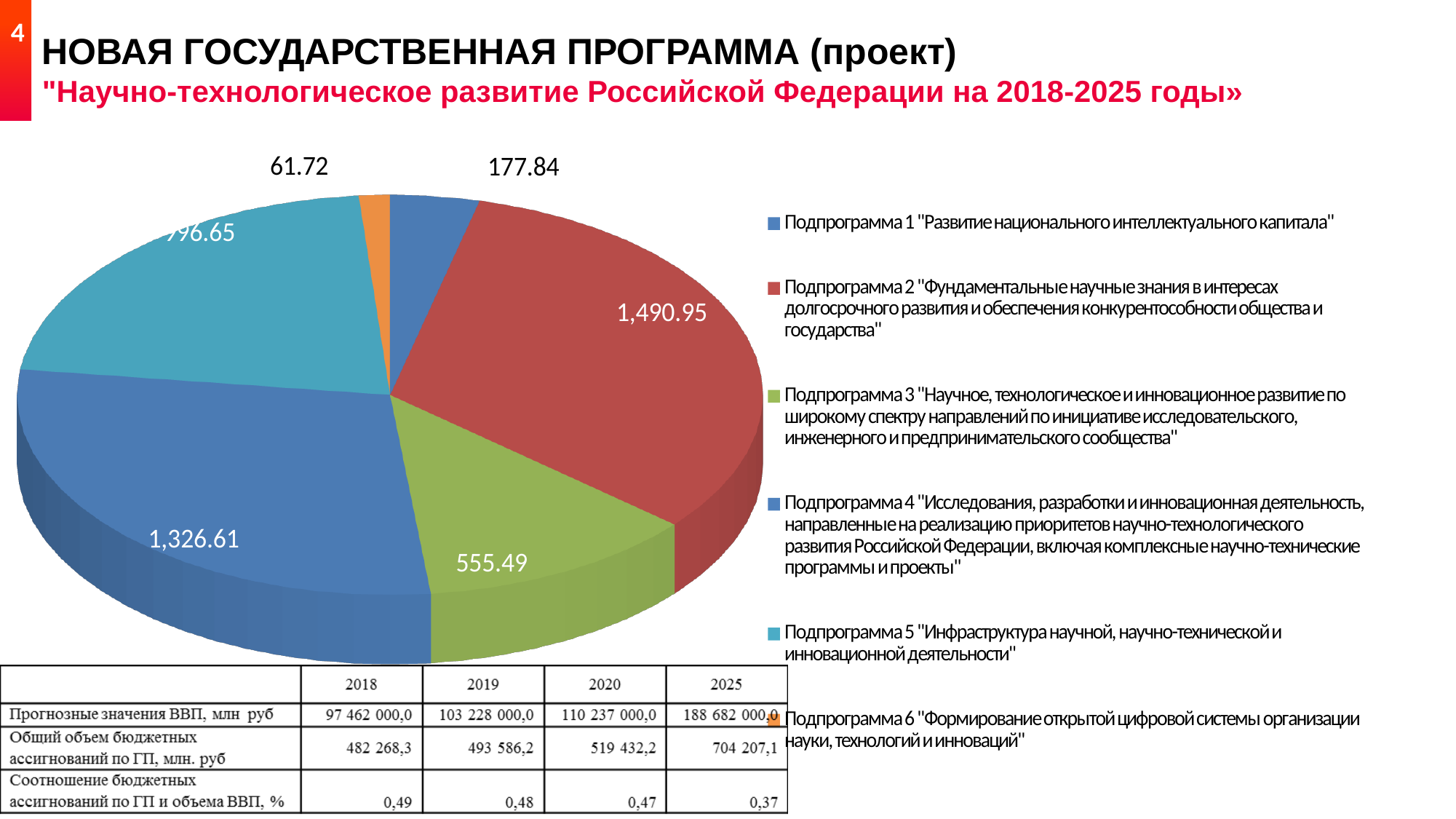
What colour is the slice for Подпрограмма 6 in the pie chart? orange How many entries does the legend of the pie chart list? 6 What type of chart is shown on the slide? pie chart Which is larger in the pie chart, the value for Подпрограмма 3 or the value for Подпрограмма 1? Подпрограмма 3 Which subprogram has the largest slice in the pie chart? Подпрограмма 2 How many slices does the pie chart have? 6 What is the value shown for Подпрограмма 2 in the pie chart? 1,490.95 What is the value shown for Подпрограмма 4 in the pie chart? 1,326.61 What is the value shown for Подпрограмма 3 in the pie chart? 555.49 What is the difference between the values for Подпрограмма 2 and Подпрограмма 4? 164.34 What is the value shown for Подпрограмма 6 in the pie chart? 61.72 Which subprogram has the smallest slice in the pie chart? Подпрограмма 6